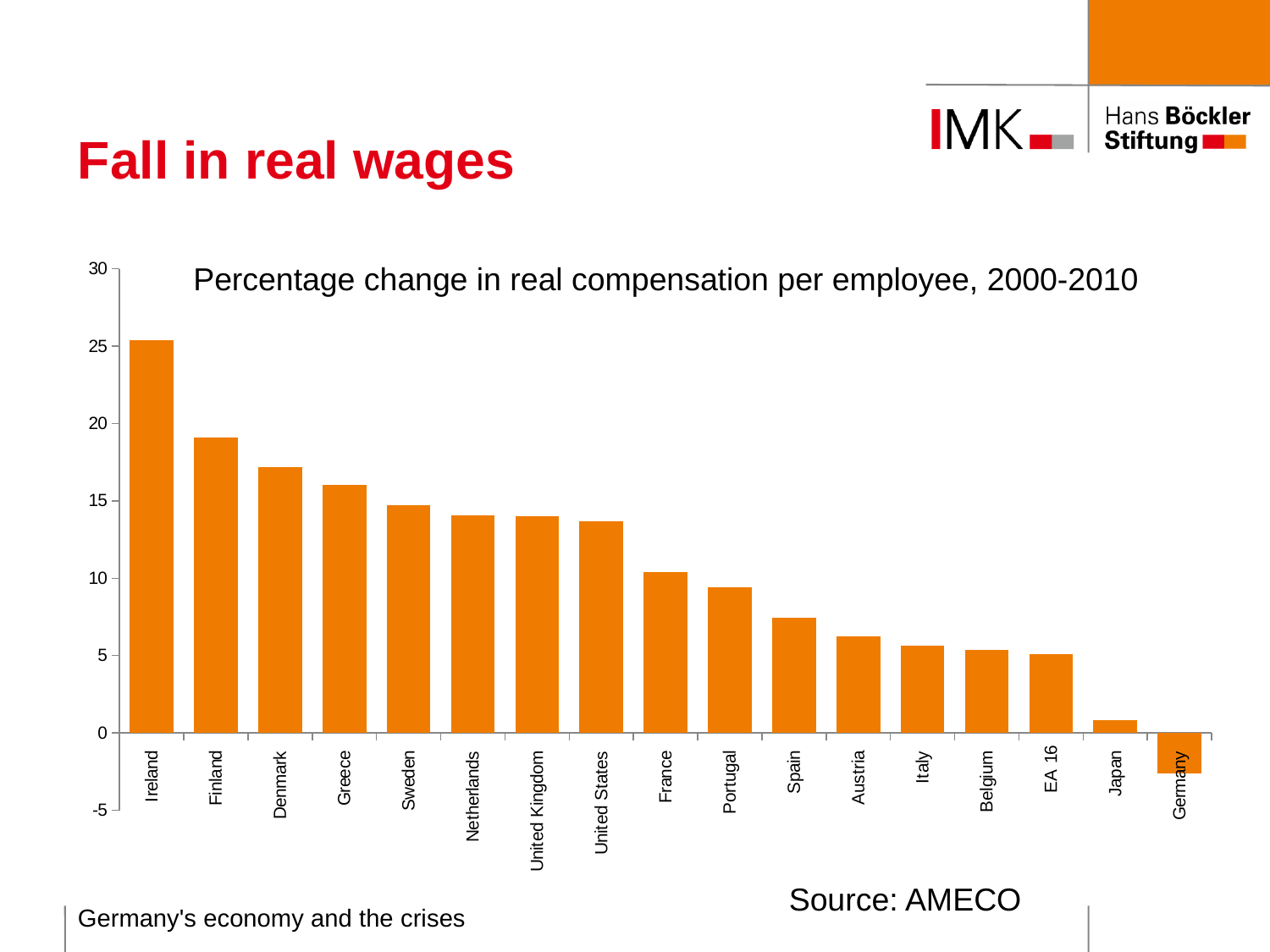
Which has the larger value, Japan or Germany? Japan What kind of chart is shown on the slide? bar chart Is the value for Ireland greater or less than 20? greater Which has the larger value, Denmark or Greece? Denmark Which country has the lowest percentage change in real compensation per employee? Germany Is the value for Germany greater or less than 0? less Which country has the highest percentage change in real compensation per employee? Ireland How many countries or regions are shown on the x axis of the chart? 17 Is the value for Finland greater or less than 20? less What is the title of the chart? Percentage change in real compensation per employee, 2000-2010 Do the values rise or fall moving from left to right along the x axis? fall